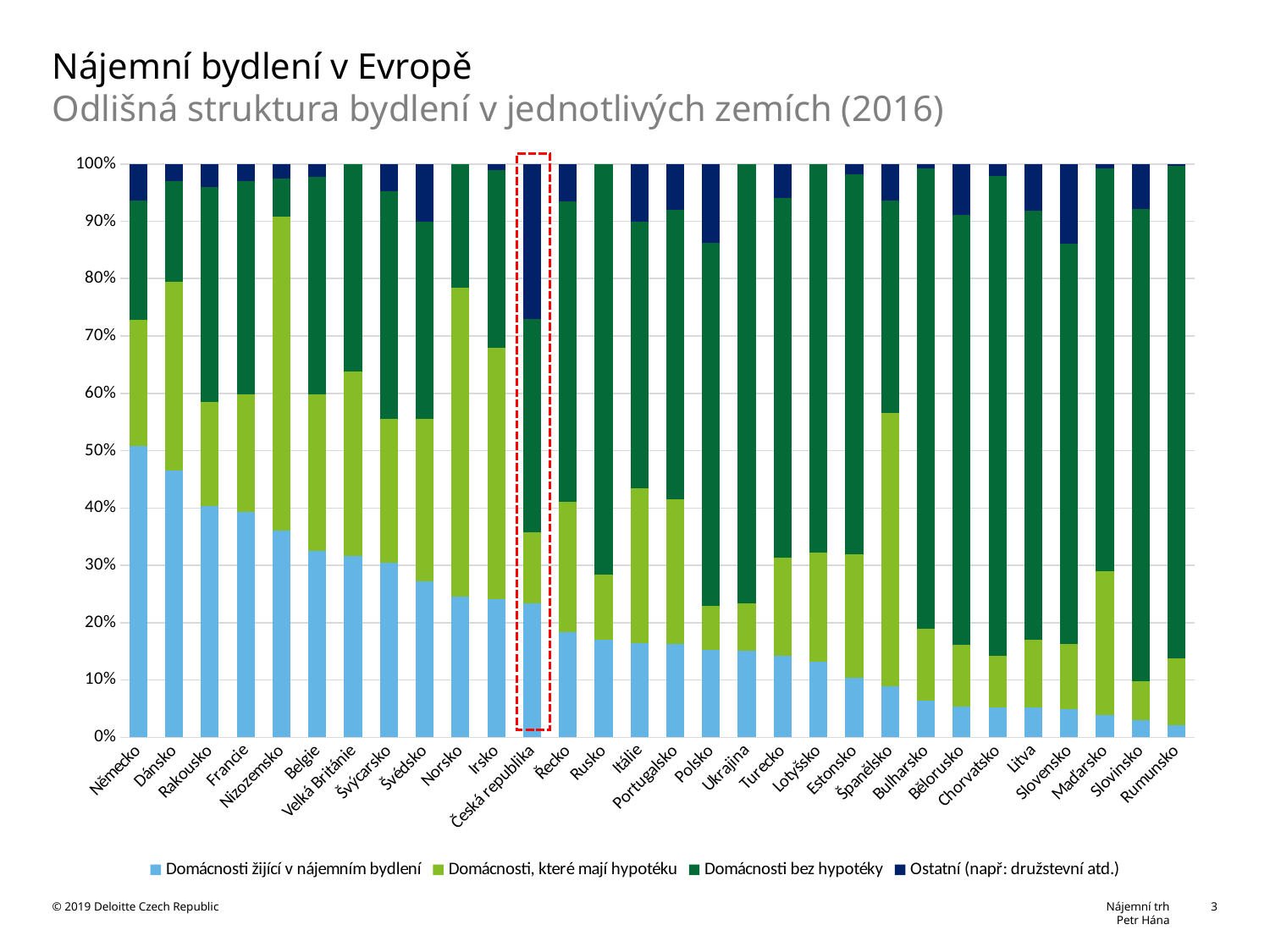
Which country has the largest share of households living in rental housing (Domácnosti žijící v nájemním bydlení)? Německo Which country has the largest share of the 'Ostatní (např: družstevní atd.)' category? Česká republika Is the share of households living in rental housing in Rumunsko greater or less than 10%? less What is the total of the stacked bar for Německo? 100% Is the share of households living in rental housing in Česká republika greater or less than 30%? less How many countries are shown on the x axis of the chart? 30 Does the share of households living in rental housing generally rise or fall from left to right along the x axis? fall Which country is highlighted with a red dashed box on the chart? Česká republika How many series does the legend list? 4 What kind of chart is shown on the slide? Stacked bar chart Is the share of households living in rental housing in Dánsko greater or less than 40%? greater Which country has a larger share of households living in rental housing, Dánsko or Rakousko? Dánsko